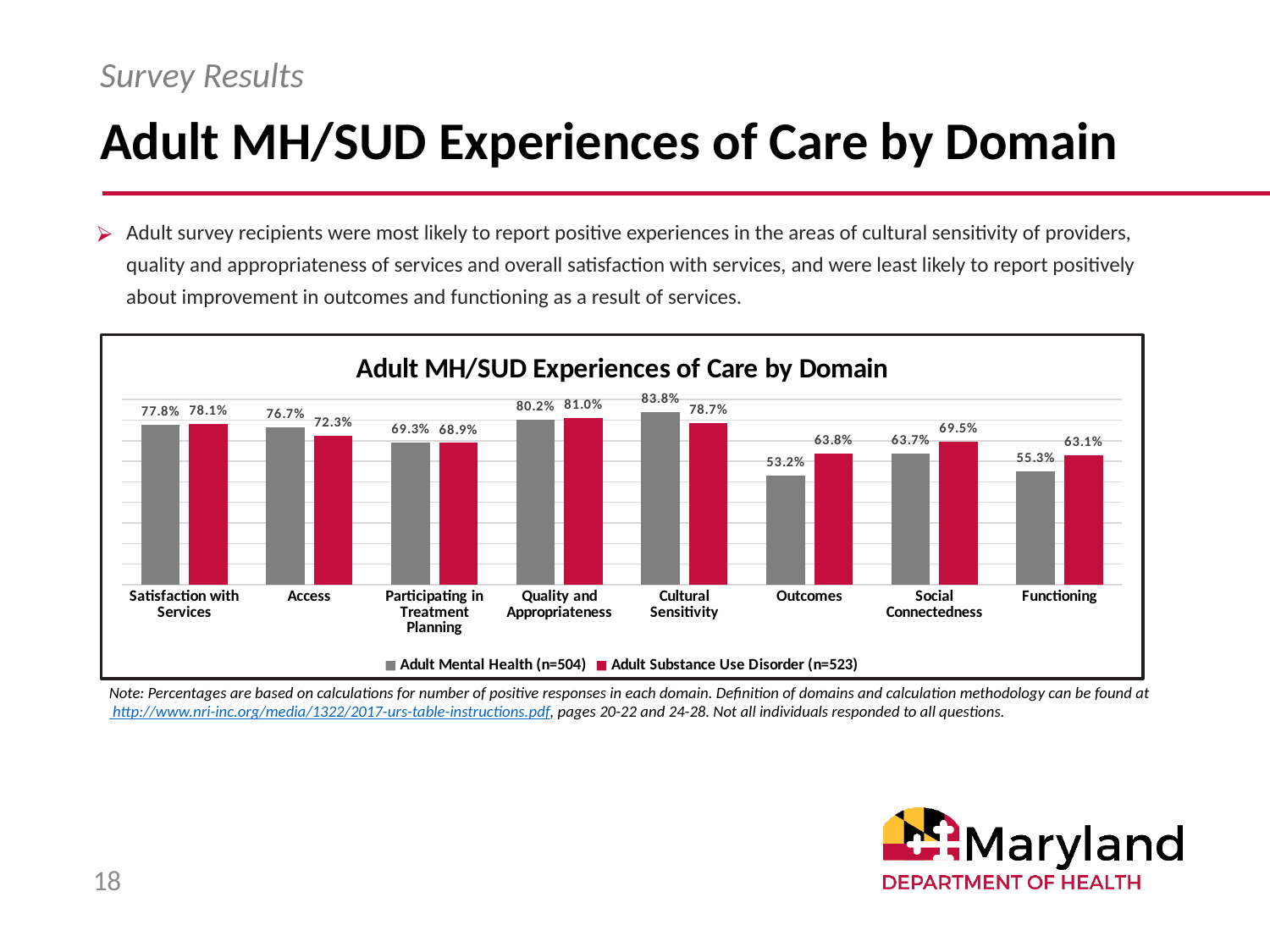
How many domains are shown on the x axis? 8 What is the Adult Mental Health value for Functioning? 55.3% What is the sample size for the Adult Substance Use Disorder series shown in the legend? n=523 How many series does the legend list? 2 What is the Adult Substance Use Disorder value for Outcomes? 63.8% What is the Adult Mental Health value for Cultural Sensitivity? 83.8% What kind of chart is shown? Bar chart Which domain has the highest Adult Mental Health value? Cultural Sensitivity What is the difference between the Adult Substance Use Disorder and Adult Mental Health values for Outcomes? 10.6% For Access, which series has the larger value, Adult Mental Health or Adult Substance Use Disorder? Adult Mental Health Which domain has the lowest Adult Mental Health value? Outcomes Which domain has the lowest Adult Substance Use Disorder value? Functioning